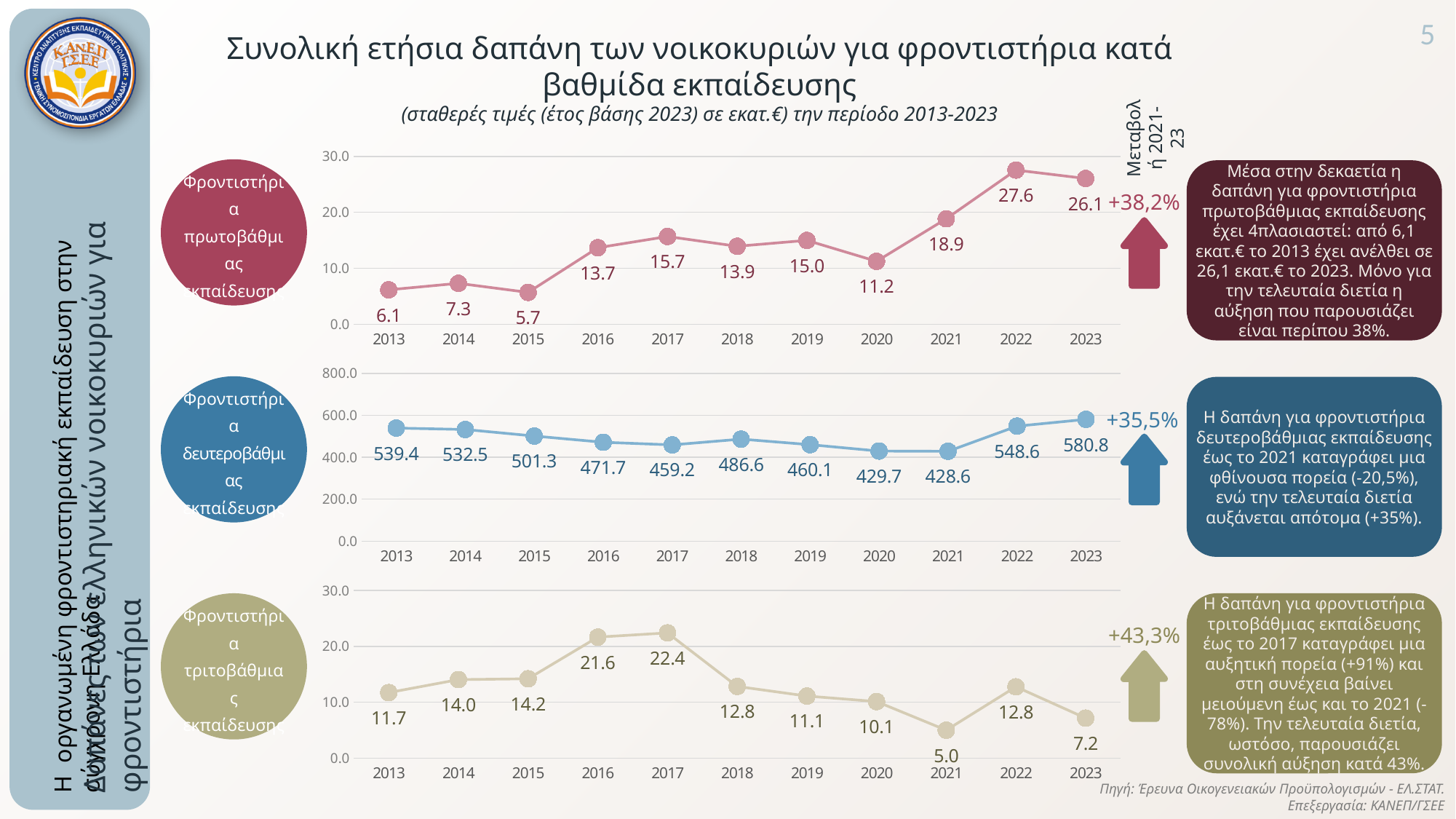
In the top chart (primary education), which year has the lowest value? 2015 In the middle chart (secondary education), what is the difference between the 2023 value and the 2013 value? 41.4 What type of chart is the middle chart (secondary education)? Line chart In the top chart (primary education), what is the value for 2023? 26.1 In the bottom chart (tertiary education), which year has the lowest value? 2021 In the top chart (primary education), is the value for 2020 greater or less than 10.0? greater In the top chart (primary education), which year has the highest value? 2022 How many years are plotted in the top chart (primary education)? 11 In the bottom chart (tertiary education), which is larger, the value for 2016 or the value for 2023? 2016 In the middle chart (secondary education), which year has the highest value? 2023 In the bottom chart (tertiary education), what is the value for 2017? 22.4 In the middle chart (secondary education), what is the value for 2021? 428.6